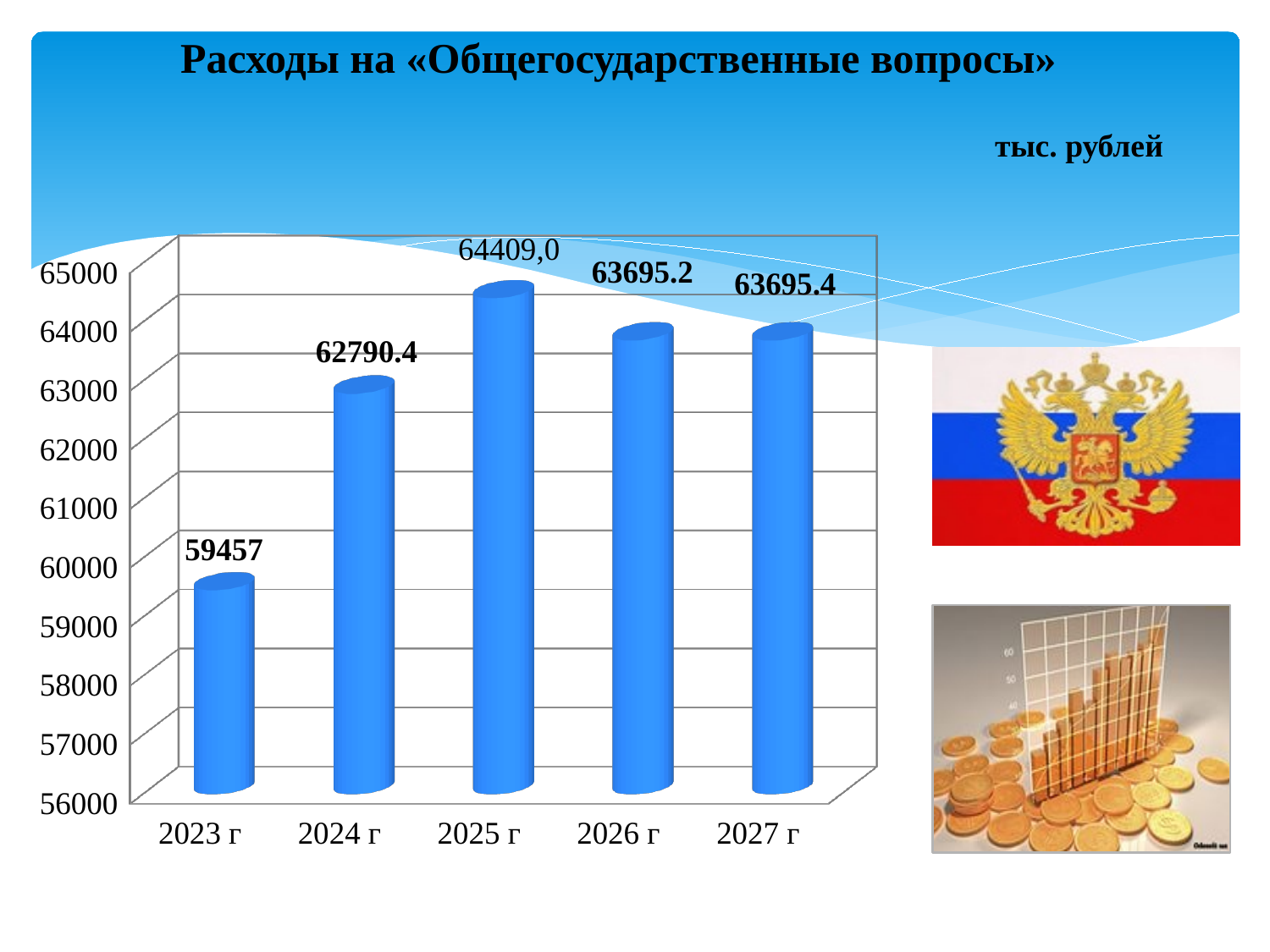
What is the value for 2023 г? 59457 Which is larger, the value for 2024 г or the value for 2026 г? 2026 г Which year has the highest value? 2025 г Is the value for 2024 г greater or less than 63000? less What kind of chart is shown on the slide? bar chart What is the value for 2025 г? 64409,0 What is the value for 2027 г? 63695.4 What is the difference between the values for 2024 г and 2023 г? 3333.4 How many years are shown on the x axis? 5 Which year has the lowest value? 2023 г What is the difference between the values for 2027 г and 2026 г? 0.2 What unit of measurement is stated on the slide for the chart values? тыс. рублей